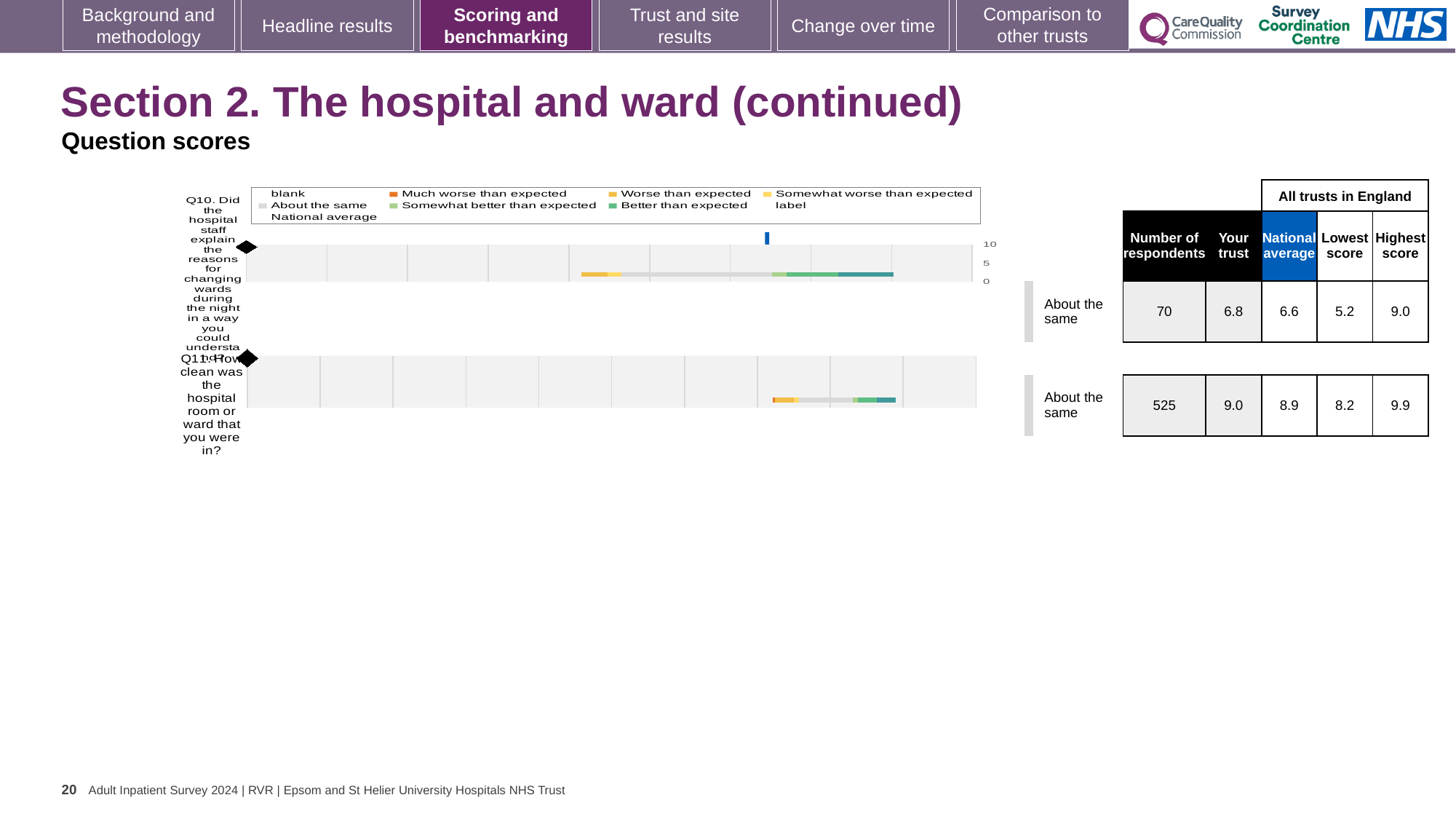
What is the 'Your trust' score for Q10 (explaining reasons for changing wards during the night)? 6.8 How many survey questions are plotted in the chart? 2 For Q11, is the 'Your trust' score higher or lower than the national average? higher What is the national average score for Q10? 6.6 What benchmark category is shown for Q10? About the same Which question has the higher 'Your trust' score, Q10 or Q11? Q11 What is the difference between the highest score and the lowest score for Q10? 3.8 How many respondents answered Q11 (how clean was the hospital room or ward)? 525 What is the highest value shown on the chart's score axis? 10 What is the 'Your trust' score for Q11? 9.0 What is the highest score among all trusts in England for Q11? 9.9 What kind of chart is used to show the question scores on this slide? bar chart